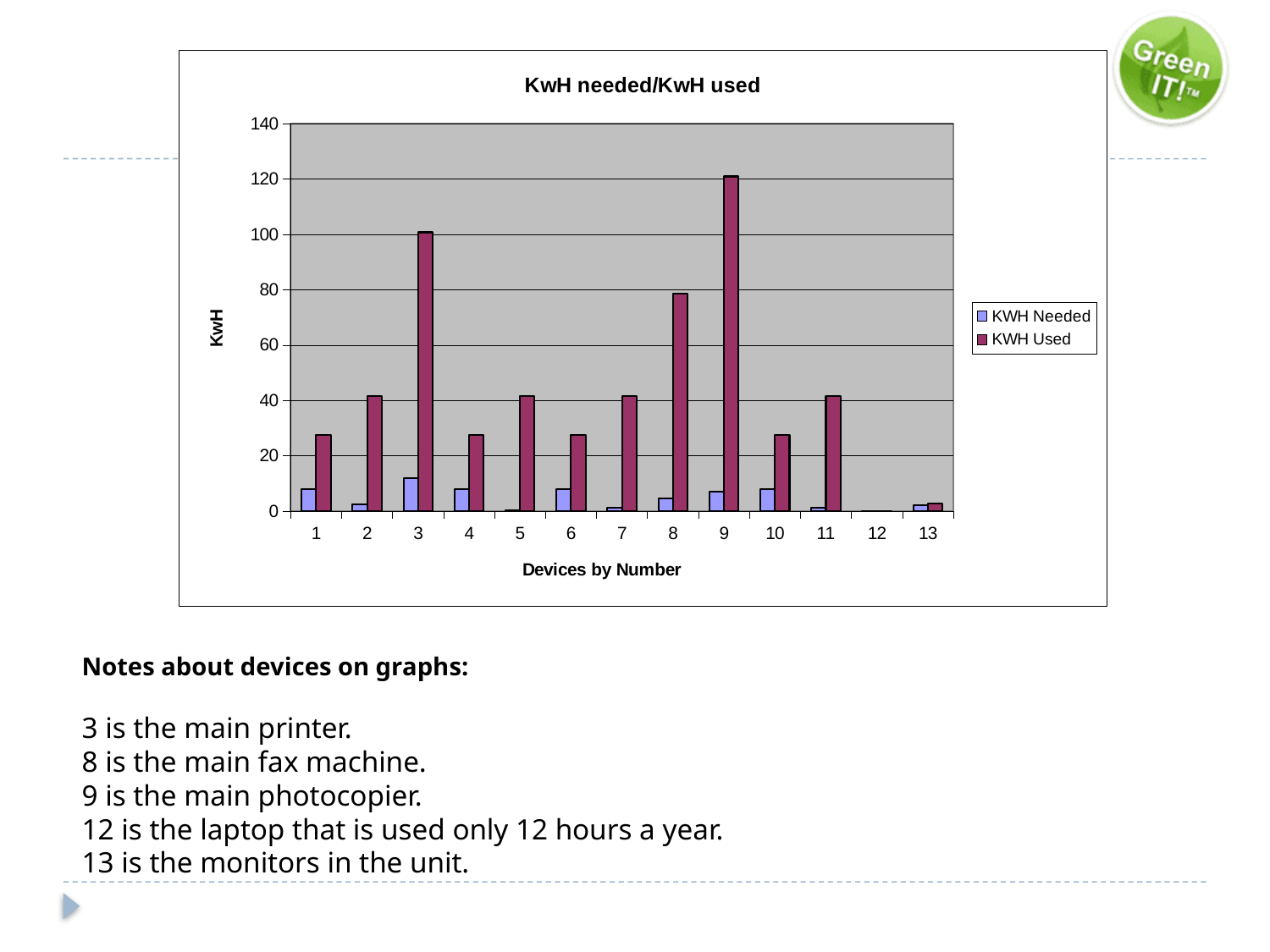
How many devices are shown on the x axis of the chart? 13 Is the KWH Used value for device 8 greater or less than 60? greater Is the KWH Used value for device 9 greater or less than 100? greater Which is larger, the KWH Used value for device 3 or for device 8? Device 3 What is the label of the x axis of the chart? Devices by Number How many series does the legend list? 2 Is the KWH Used value for device 1 greater or less than 40? less Which device has the highest KWH Used value? 9 Which device has the lowest KWH Used value? 12 Which device has the highest KWH Needed value? 3 What type of chart is shown on the slide? Bar chart What is the title of the chart? KwH needed/KwH used